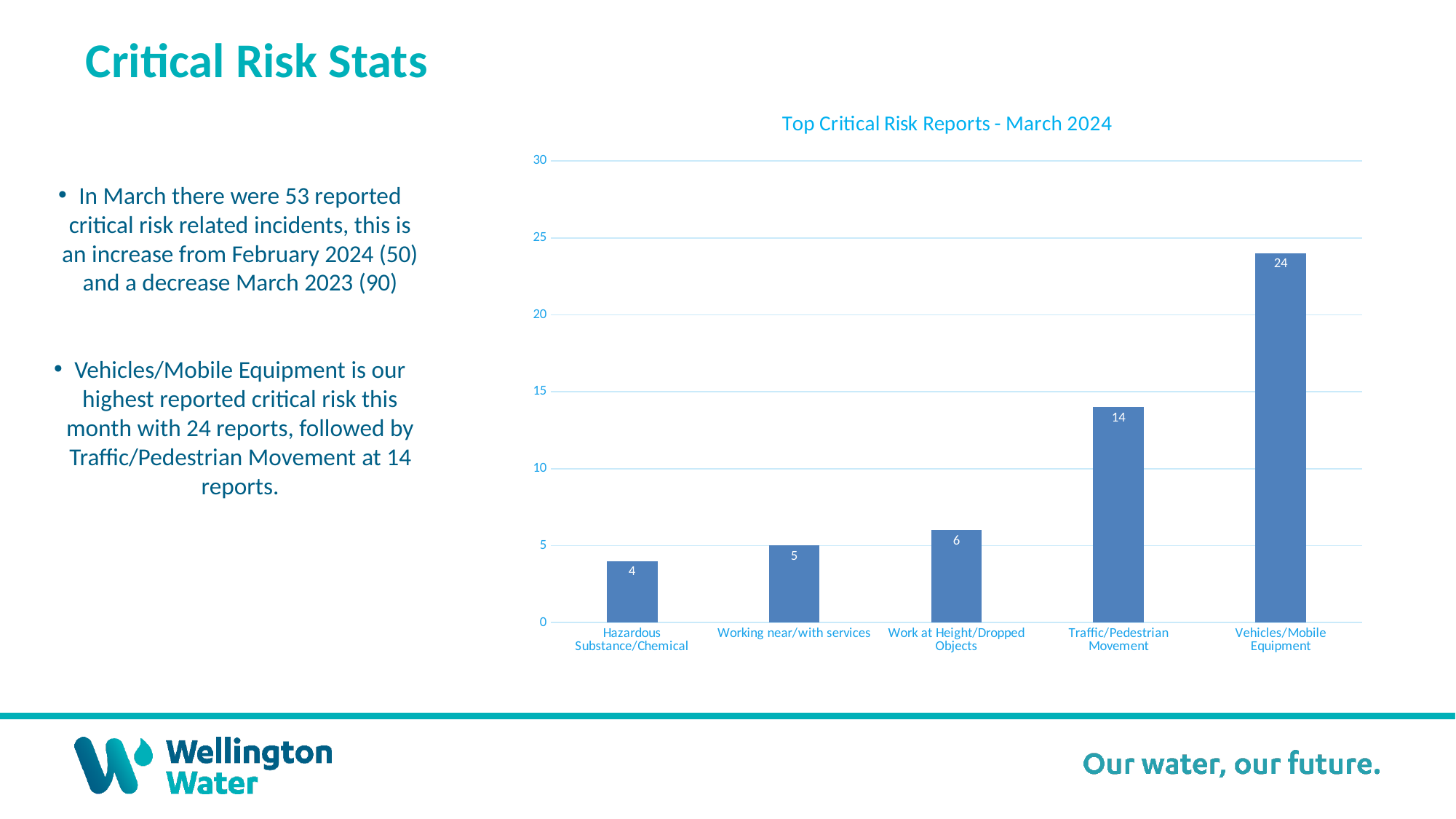
Is the value for Vehicles/Mobile Equipment greater or less than 20? greater What is the value for Hazardous Substance/Chemical? 4 How many categories are shown on the chart? 5 What is the value for Vehicles/Mobile Equipment? 24 Which is larger, Working near/with services or Work at Height/Dropped Objects? Work at Height/Dropped Objects Which category has the lowest value? Hazardous Substance/Chemical What kind of chart is shown? bar chart What is the difference between Vehicles/Mobile Equipment and Traffic/Pedestrian Movement? 10 What is the value for Work at Height/Dropped Objects? 6 What is the value for Traffic/Pedestrian Movement? 14 Which category has the highest value? Vehicles/Mobile Equipment What is the title of the chart? Top Critical Risk Reports - March 2024